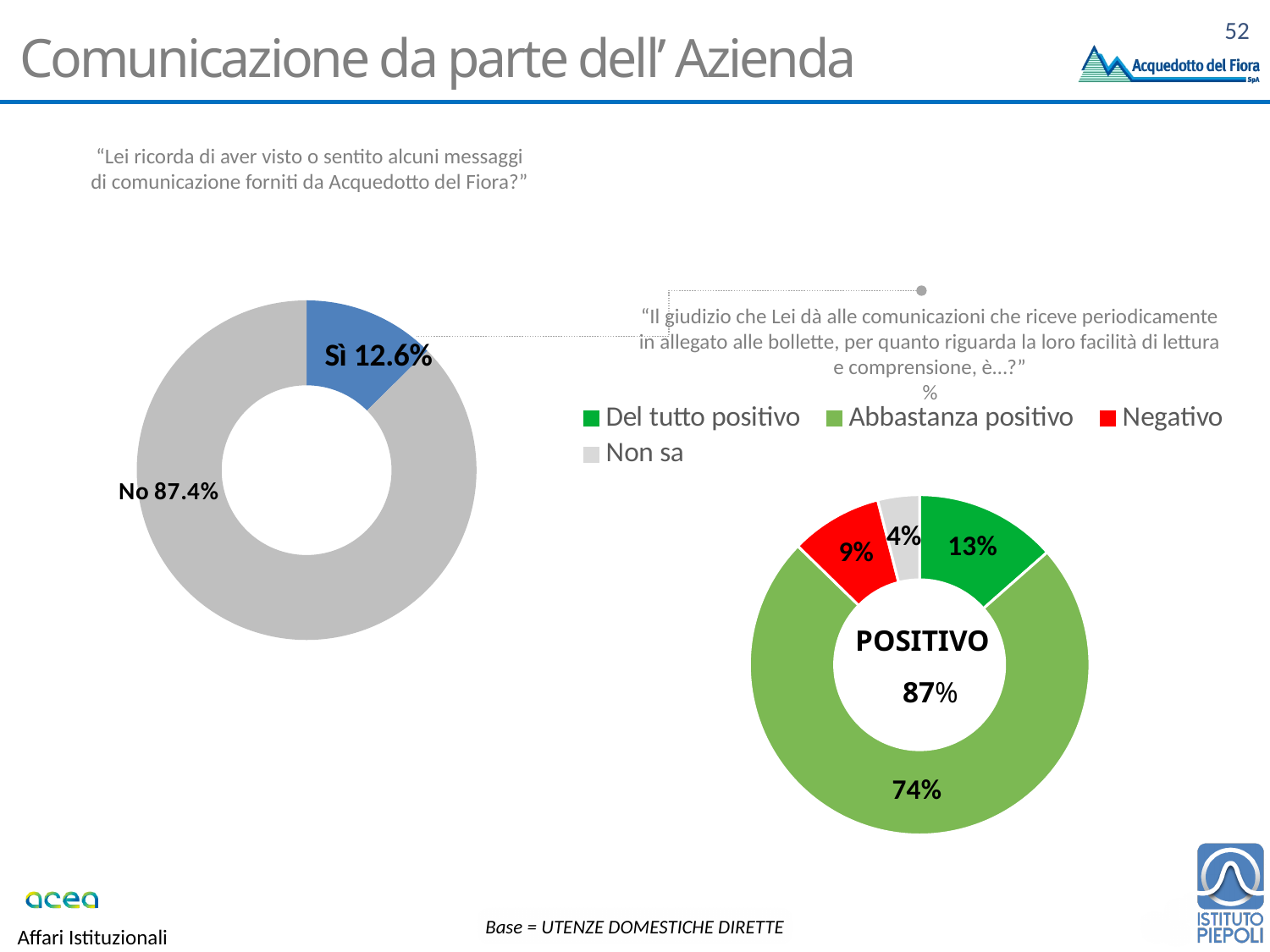
In the right donut chart, what combined percentage is shown in the centre for "POSITIVO"? 87% In the left donut chart, what is the difference in percentage points between "No" and "Sì"? 74.8 What kind of chart is the left chart on the slide? Donut (pie) chart In the right donut chart, what percentage is shown for "Negativo"? 9% In the left donut chart, what percentage of respondents answered "Sì"? 12.6% In the right donut chart, what percentage is shown for "Del tutto positivo"? 13% In the left donut chart, which category has the larger share, "Sì" or "No"? No In the right donut chart, which category has the smallest share? Non sa In the right donut chart, which category has the largest share? Abbastanza positivo How many categories does the legend of the right donut chart list? 4 In the left donut chart, what percentage of respondents answered "No"? 87.4% In the right donut chart, what percentage is shown for "Abbastanza positivo"? 74%